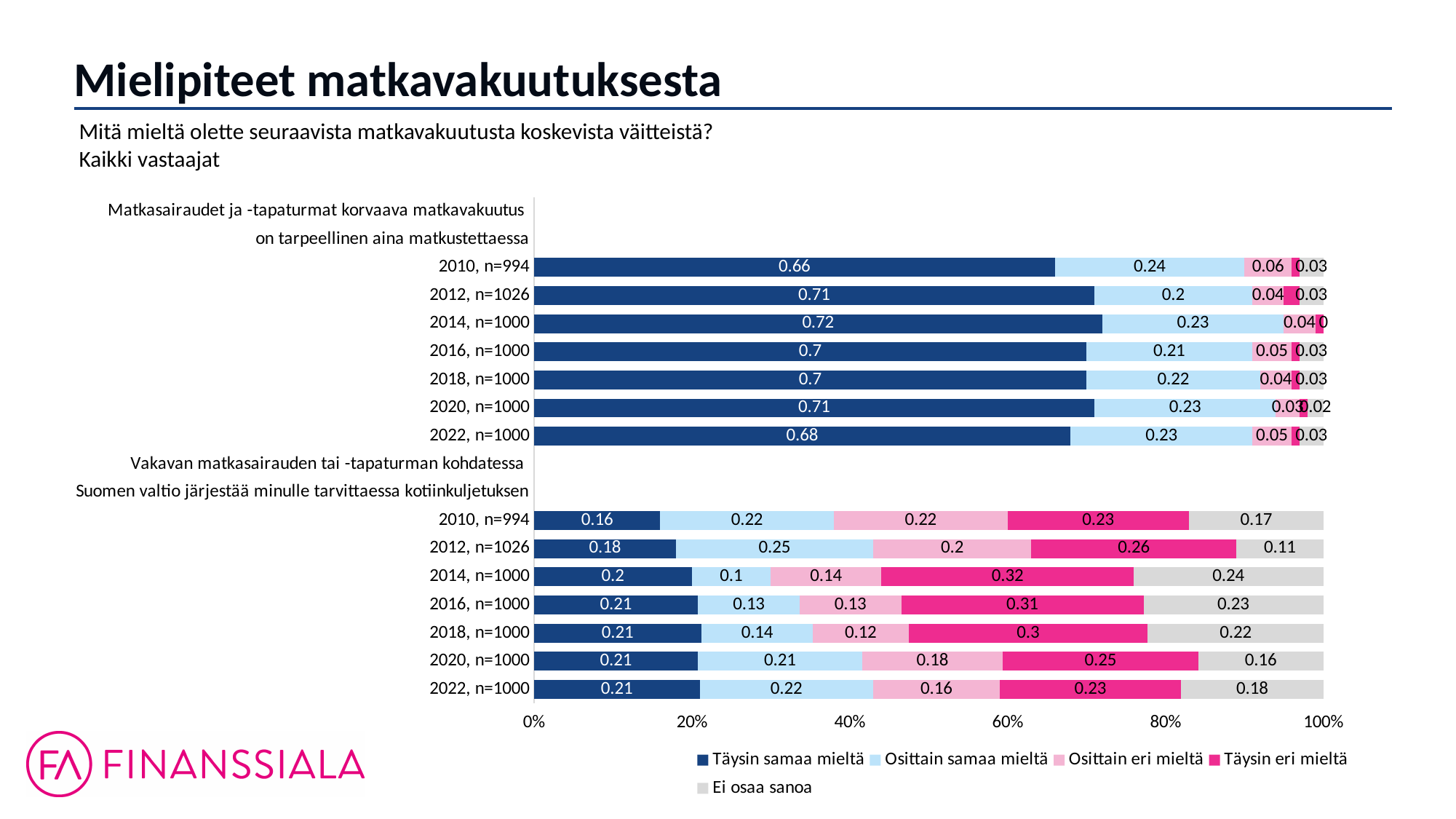
For the statement about the Finnish state arranging transport home, does the 'Täysin samaa mieltä' value rise or fall from 2010 to 2022? Rise For the statement about travel insurance being necessary when travelling, what is the 'Osittain samaa mieltä' value for 2010, n=994? 0.24 How many series does the legend list? 5 For the statement about travel insurance being necessary when travelling, which year has the lowest 'Täysin samaa mieltä' value? 2010, n=994 For the statement 'Matkasairaudet ja -tapaturmat korvaava matkavakuutus on tarpeellinen aina matkustettaessa', what is the 'Täysin samaa mieltä' value for 2014, n=1000? 0.72 For the statement about travel insurance being necessary when travelling, which year has the highest 'Täysin samaa mieltä' value? 2014, n=1000 For the statement about the Finnish state arranging transport home, what is the difference between the 'Ei osaa sanoa' values for 2014, n=1000 and 2012, n=1026? 0.13 What kind of chart is shown on the slide? Stacked bar chart For the statement about the Finnish state arranging transport home in 2014, n=1000, which is larger: 'Täysin eri mieltä' or 'Ei osaa sanoa'? Täysin eri mieltä For the statement 'Vakavan matkasairauden tai -tapaturman kohdatessa Suomen valtio järjestää minulle tarvittaessa kotiinkuljetuksen', what is the 'Täysin eri mieltä' value for 2014, n=1000? 0.32 For the statement about the Finnish state arranging transport home, which year has the highest 'Ei osaa sanoa' value? 2014, n=1000 How many survey years are shown for each statement? 7